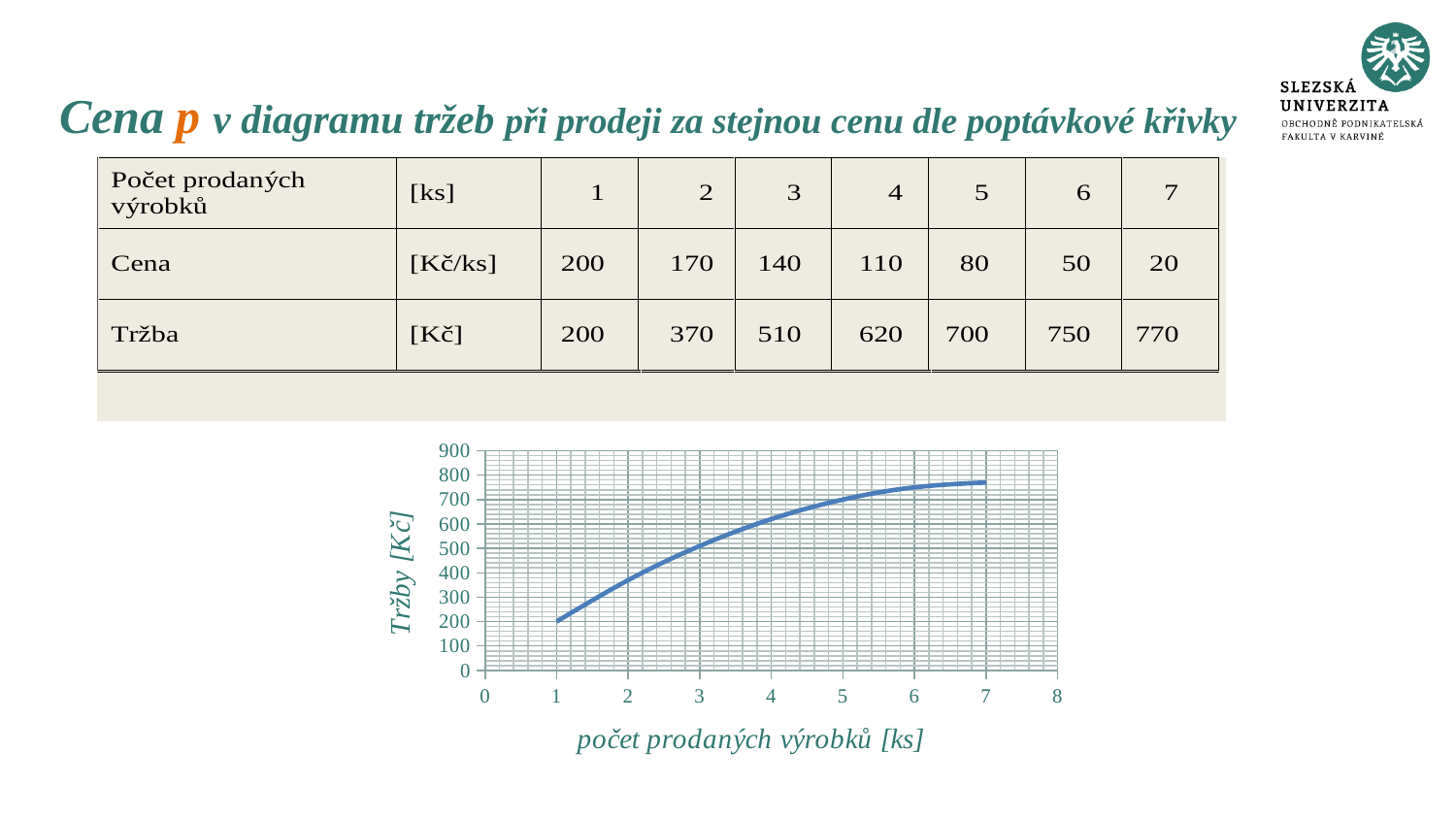
At which number of products sold is the plotted revenue highest? 7 Do the values on the chart rise or fall as the number of products sold increases? rise What is the revenue (Tržba) plotted for 5 products sold? 700 What is the revenue (Tržba) plotted for 1 product sold? 200 Is the revenue for 2 products sold greater or less than 400? less What is the revenue (Tržba) plotted for 7 products sold? 770 Is the revenue for 6 products sold greater or less than 800? less What is the label of the horizontal axis of the chart? počet prodaných výrobků [ks] How many data points are plotted on the chart? 7 What kind of chart is shown on the slide? line chart What is the label of the vertical axis of the chart? Tržby [Kč] What is the difference between the revenue for 7 products sold and the revenue for 1 product sold? 570